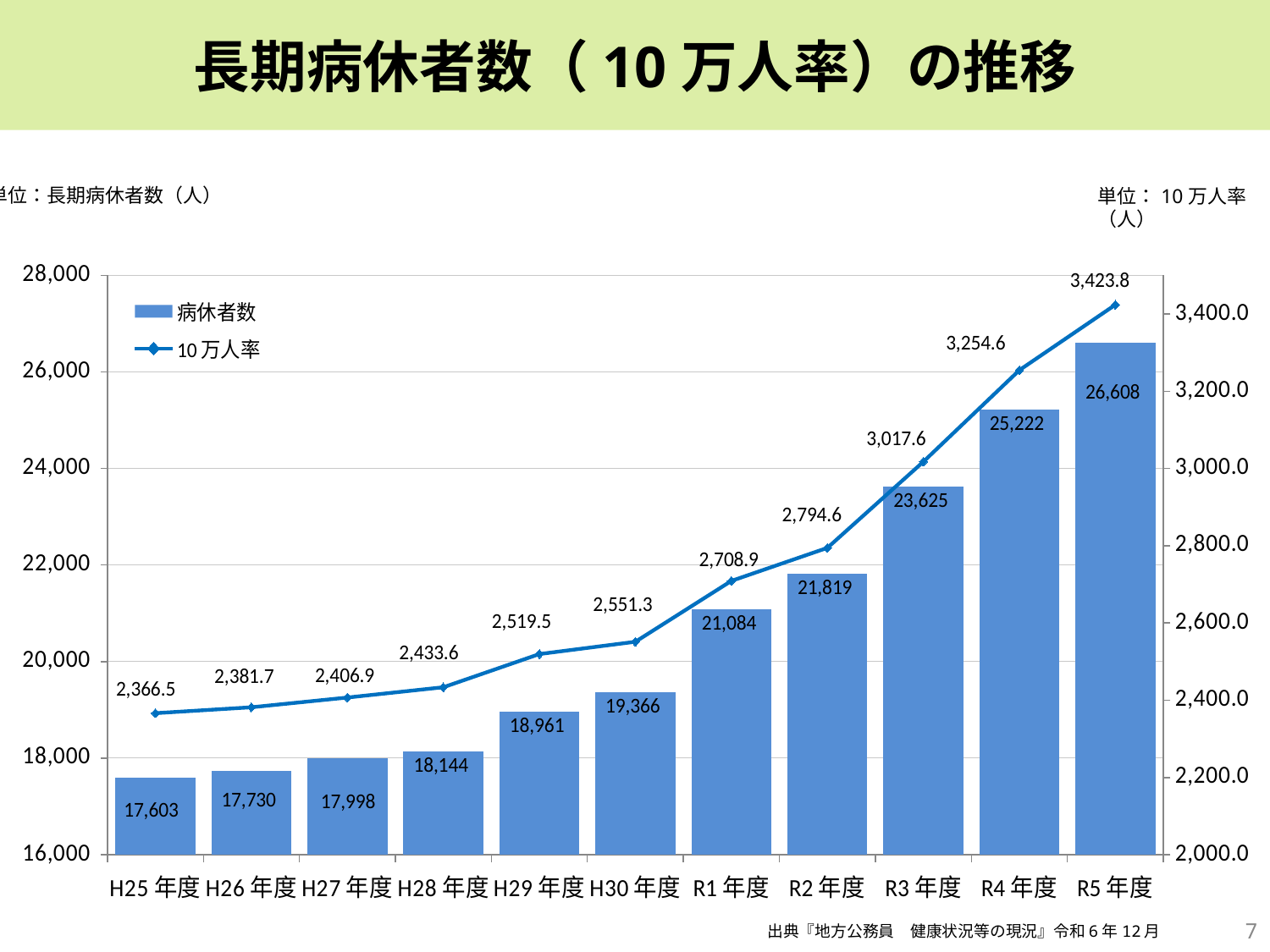
How many years (categories) are shown on the x axis? 11 How many series does the legend list? 2 What is the 病休者数 value for H25年度? 17,603 What is the difference in 病休者数 between R5年度 and R4年度? 1,386 Which year has the highest 10万人率 value? R5年度 Which year has the lowest 病休者数 value? H25年度 What is the 10万人率 value for H29年度? 2,519.5 What kind of chart is used for the 病休者数 series? bar chart Which is larger, the 病休者数 for R1年度 or for H30年度? R1年度 What is the 病休者数 value for R5年度? 26,608 Is the 病休者数 value for R3年度 greater or less than 22,000? greater Do the 10万人率 values rise or fall from H25年度 to R5年度? rise